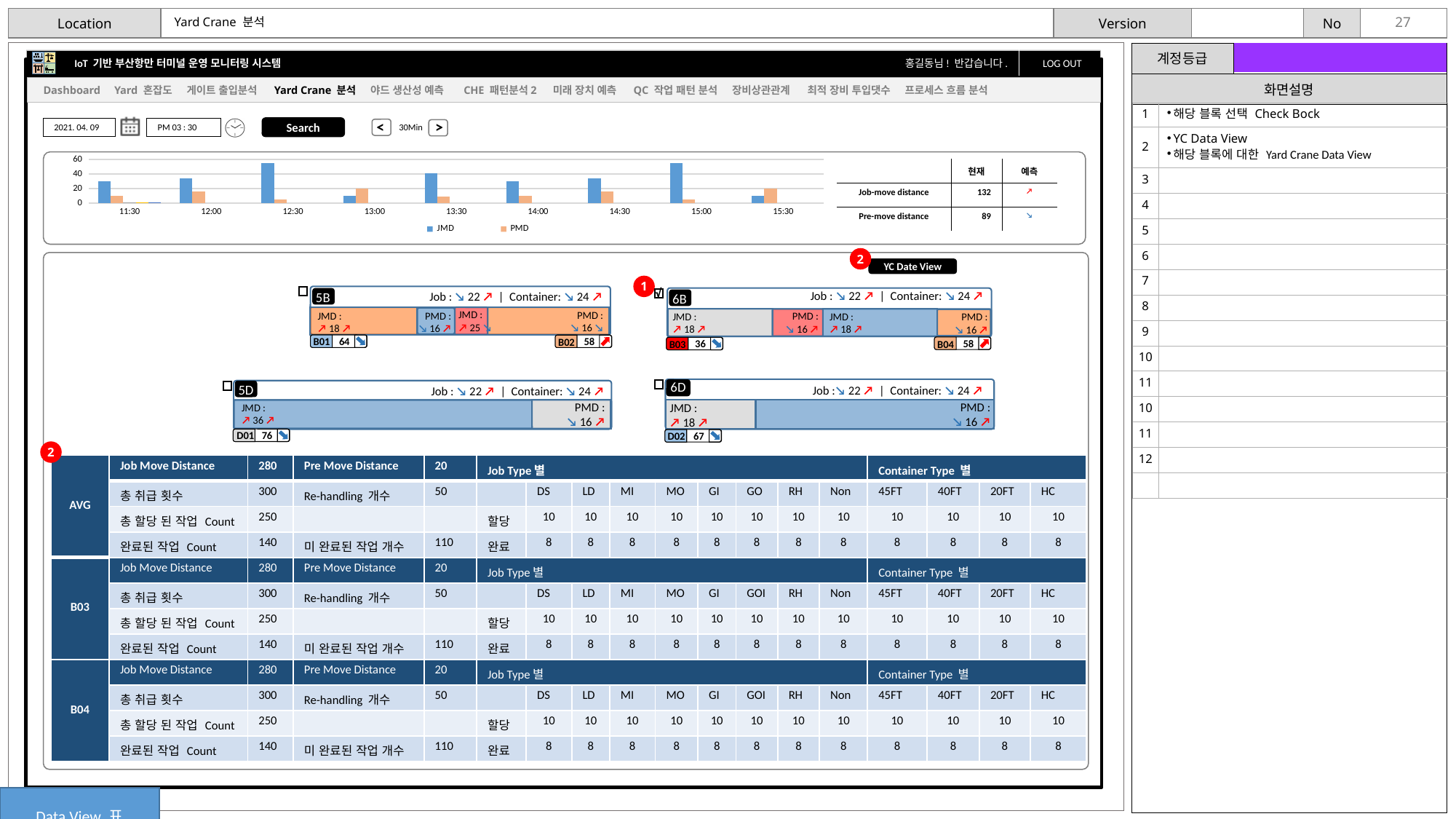
In the top bar chart, is the PMD value at 12:30 greater or less than 20? less In the top bar chart, is the JMD value at 12:30 greater or less than 40? greater In the top bar chart, is the PMD value at 13:00 greater or less than 40? less How many series does the legend of the top bar chart list? 2 In the top bar chart, which series has the larger value at 13:00, JMD or PMD? PMD What are the two series named in the legend of the top bar chart? JMD and PMD In the top bar chart, which series has the larger value at 12:30, JMD or PMD? JMD How many time points are shown on the x axis of the top bar chart? 9 What kind of chart is shown at the top of the slide? bar chart What is the highest tick value shown on the y axis of the top bar chart? 60